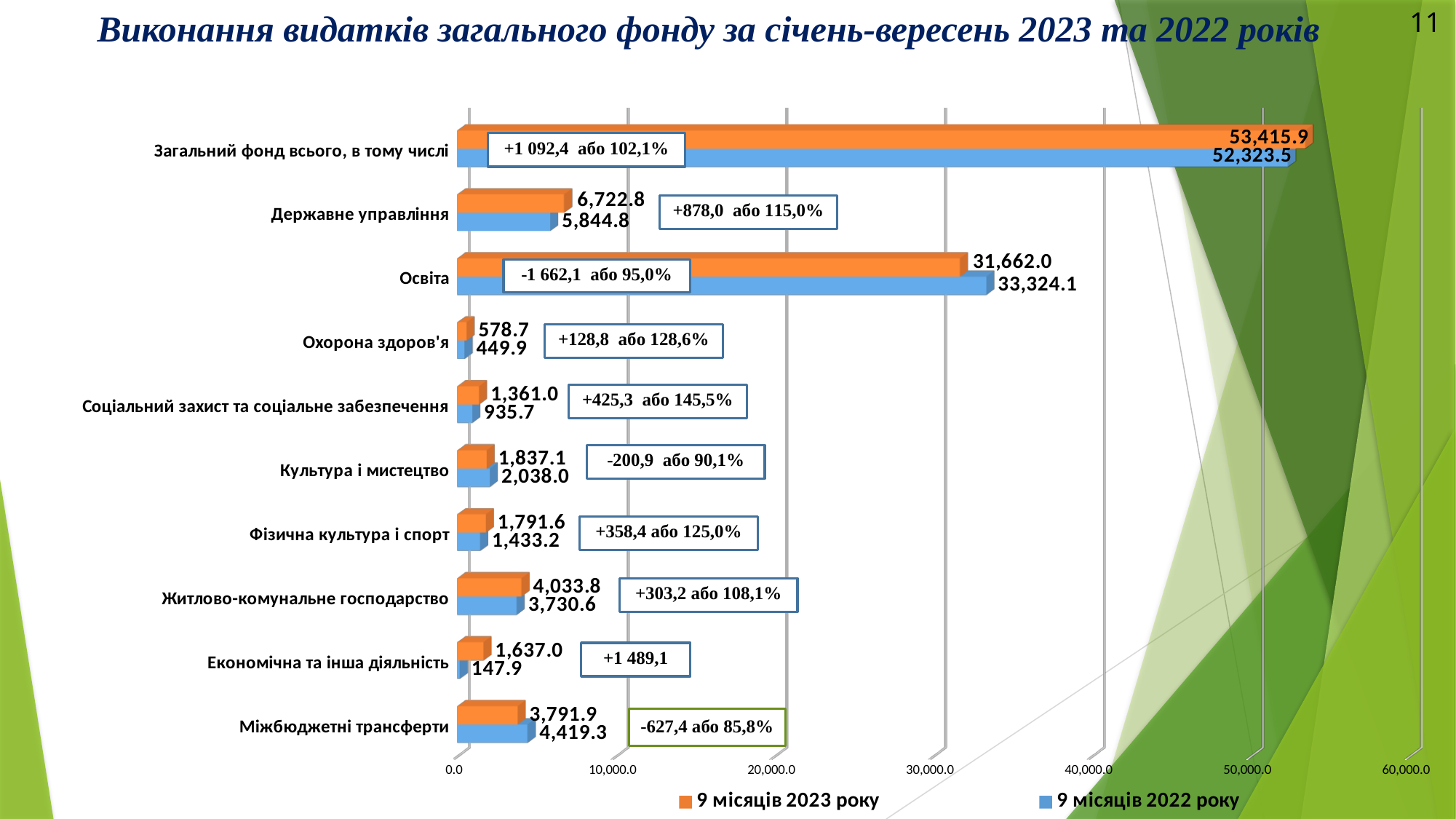
What is the value for Економічна та інша діяльність in the 9 місяців 2022 року series? 147.9 How many series does the legend list? 2 What is the difference between the 2022 and 2023 values for Освіта? 1,662.1 Which category has the highest value in the 9 місяців 2023 року series? Загальний фонд всього, в тому числі For Культура і мистецтво, which series has the larger value, 9 місяців 2023 року or 9 місяців 2022 року? 9 місяців 2022 року How many categories are shown on the chart? 10 What is the value for Державне управління in the 9 місяців 2022 року series? 5,844.8 What kind of chart is shown on the slide? bar chart Is the value for Освіта in the 9 місяців 2022 року series greater or less than 30,000.0? greater What is the value for Освіта in the 9 місяців 2023 року series? 31,662.0 What is the value for Охорона здоров'я in the 9 місяців 2023 року series? 578.7 Which category has the lowest value in the 9 місяців 2022 року series? Економічна та інша діяльність